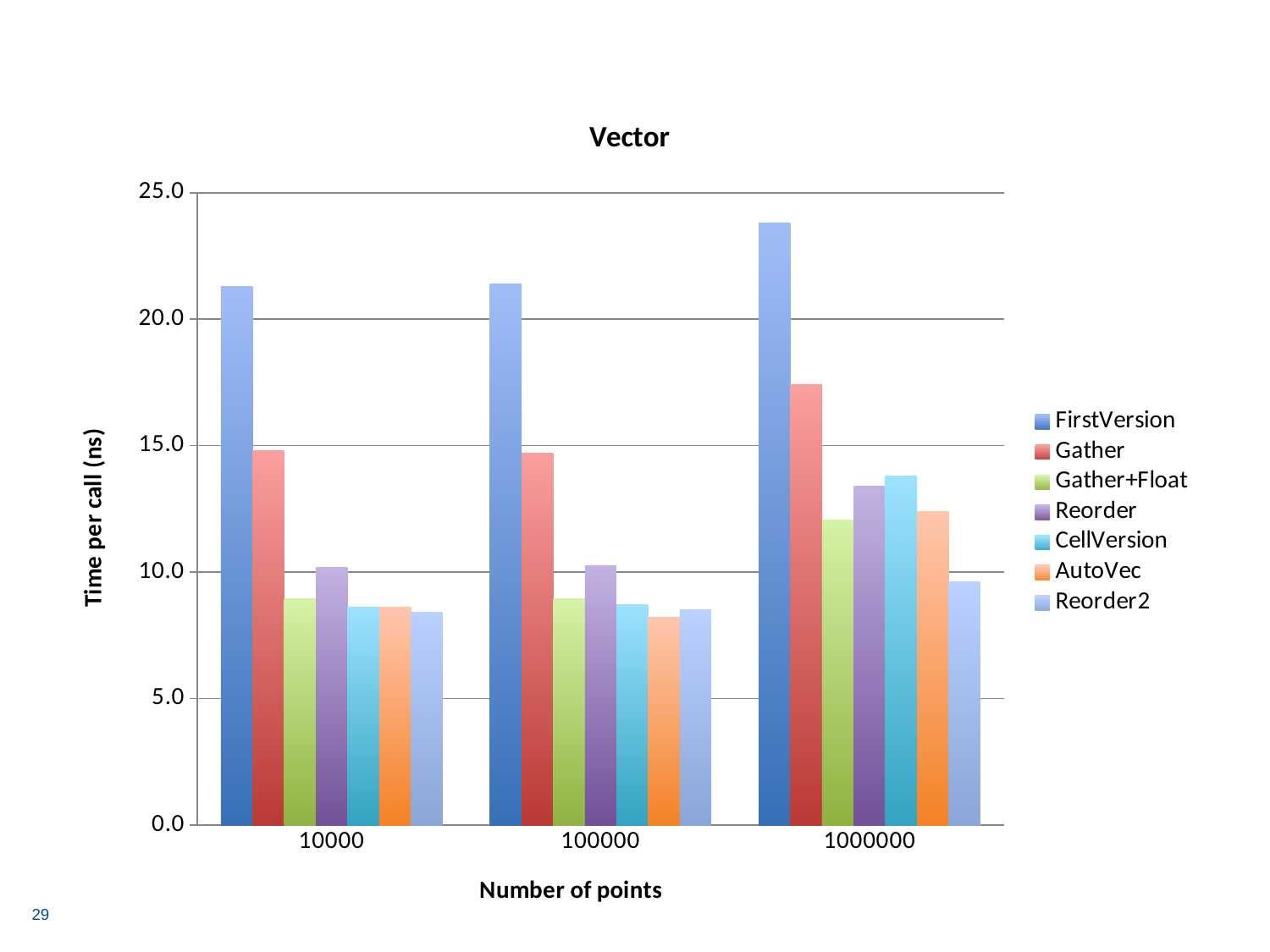
Which series has the highest value at 1000000 points? FirstVersion Which is larger at 1000000 points, Gather or Reorder? Gather Is the value for Gather at 100000 points greater or less than 15.0? less Which series has the lowest value at 1000000 points? Reorder2 What is the label of the y axis? Time per call (ns) Is the value for Reorder2 at 1000000 points greater or less than 10.0? less Does the FirstVersion value rise or fall as the number of points increases from 100000 to 1000000? rise What is the title of the chart? Vector How many categories are shown on the x axis? 3 Is the value for FirstVersion at 10000 points greater or less than 20.0? greater What type of chart is shown on the slide? bar chart How many series does the legend list? 7